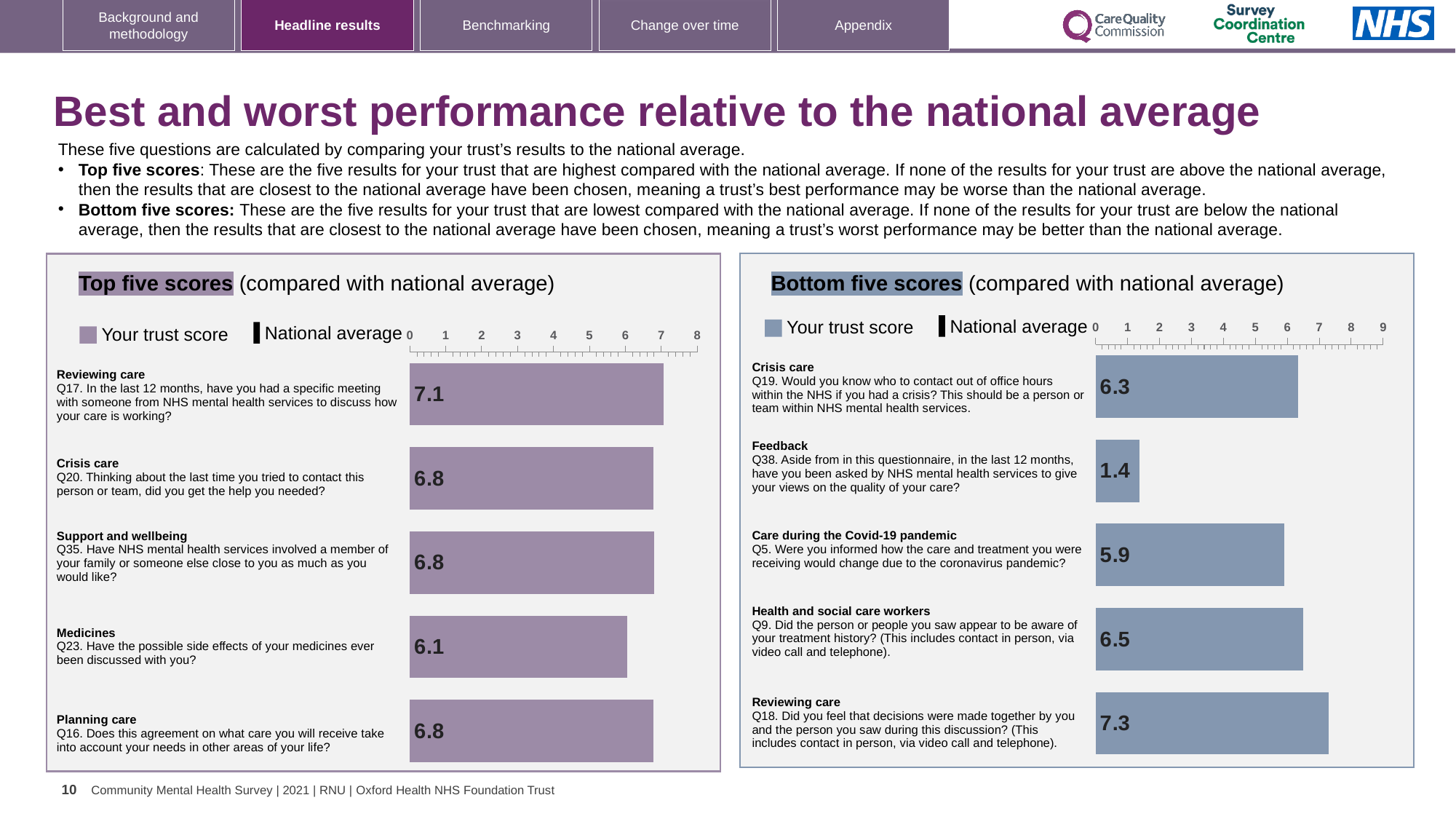
In the Bottom five scores chart, what is the difference between the trust scores for Q18 and Q38? 5.9 In the Bottom five scores chart, which question has the highest trust score? Q18 (Reviewing care) In the Top five scores chart, what is the trust score for Q17 (Reviewing care)? 7.1 In the Top five scores chart, which question has the highest trust score? Q17 (Reviewing care) In the Bottom five scores chart, which question has the lowest trust score? Q38 (Feedback) In the Bottom five scores chart, what is the trust score for Q38 (Feedback)? 1.4 In the Bottom five scores chart, is the trust score for Q9 (Health and social care workers) greater or less than 5? greater In the Top five scores chart, which has the larger trust score, Q17 or Q23? Q17 How many questions are shown in the Bottom five scores chart? 5 In the Bottom five scores chart, what is the trust score for Q5 (Care during the Covid-19 pandemic)? 5.9 In the Top five scores chart, what is the trust score for Q23 (Medicines)? 6.1 What kind of chart is the Top five scores chart? Bar chart